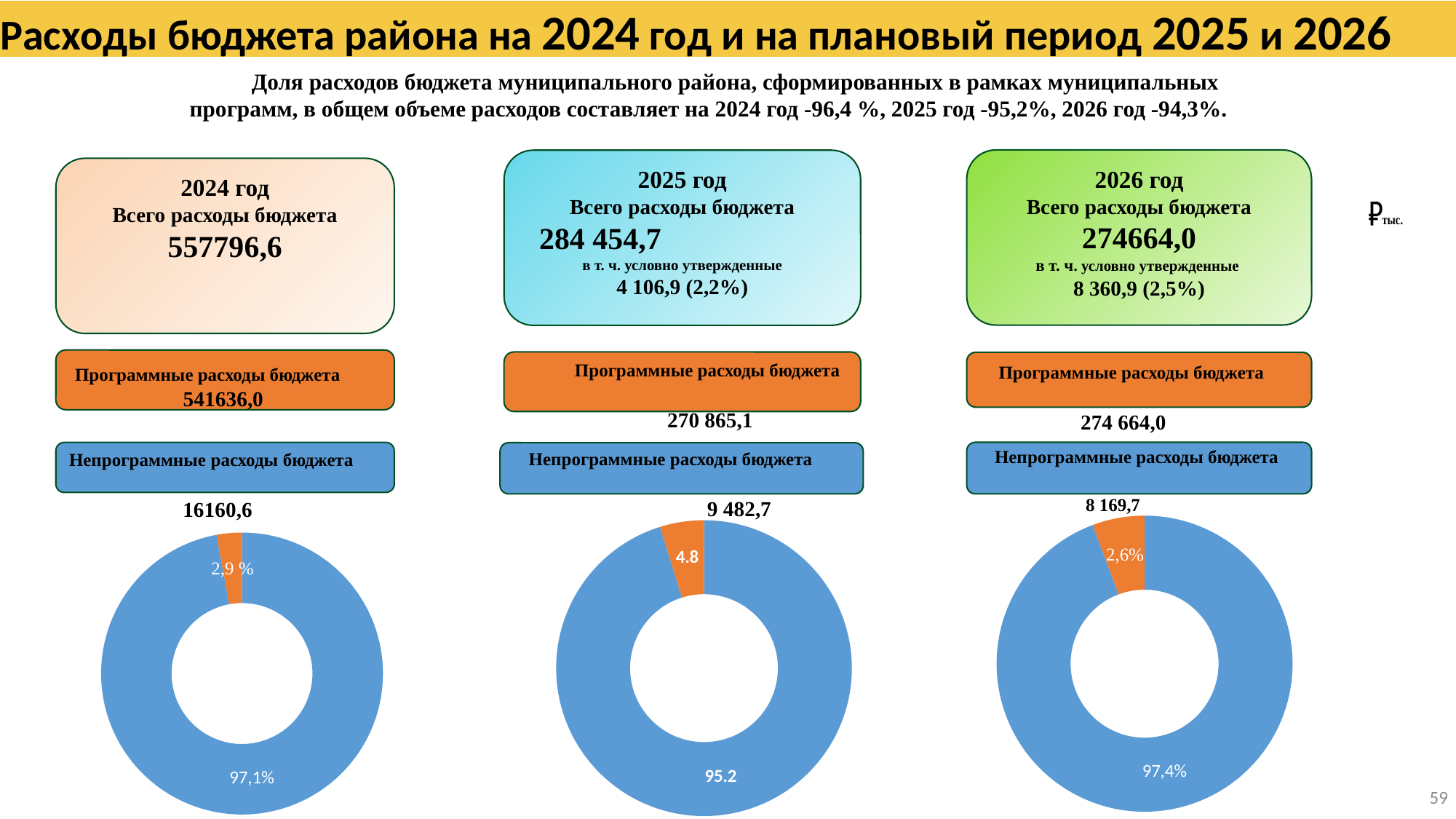
In the middle doughnut chart (2025), what value is shown on the orange slice? 4.8 In the left doughnut chart (2024), what percentage is shown on the small orange slice? 2,9 % In the right doughnut chart (2026), what percentage is shown on the orange slice? 2,6% In the right doughnut chart (2026), which slice is larger, the blue one or the orange one? The blue one In the left doughnut chart (2024), what percentage is shown on the large blue slice? 97,1% What kind of chart is shown under the 2024 box on the left of the slide? Doughnut (pie) chart In the right doughnut chart (2026), what percentage is shown on the blue slice? 97,4% In the middle doughnut chart (2025), what value is shown on the blue slice? 95.2 What colour is the slice representing the larger share in each of the three doughnut charts? Blue How many slices does each doughnut chart on the slide have? 2